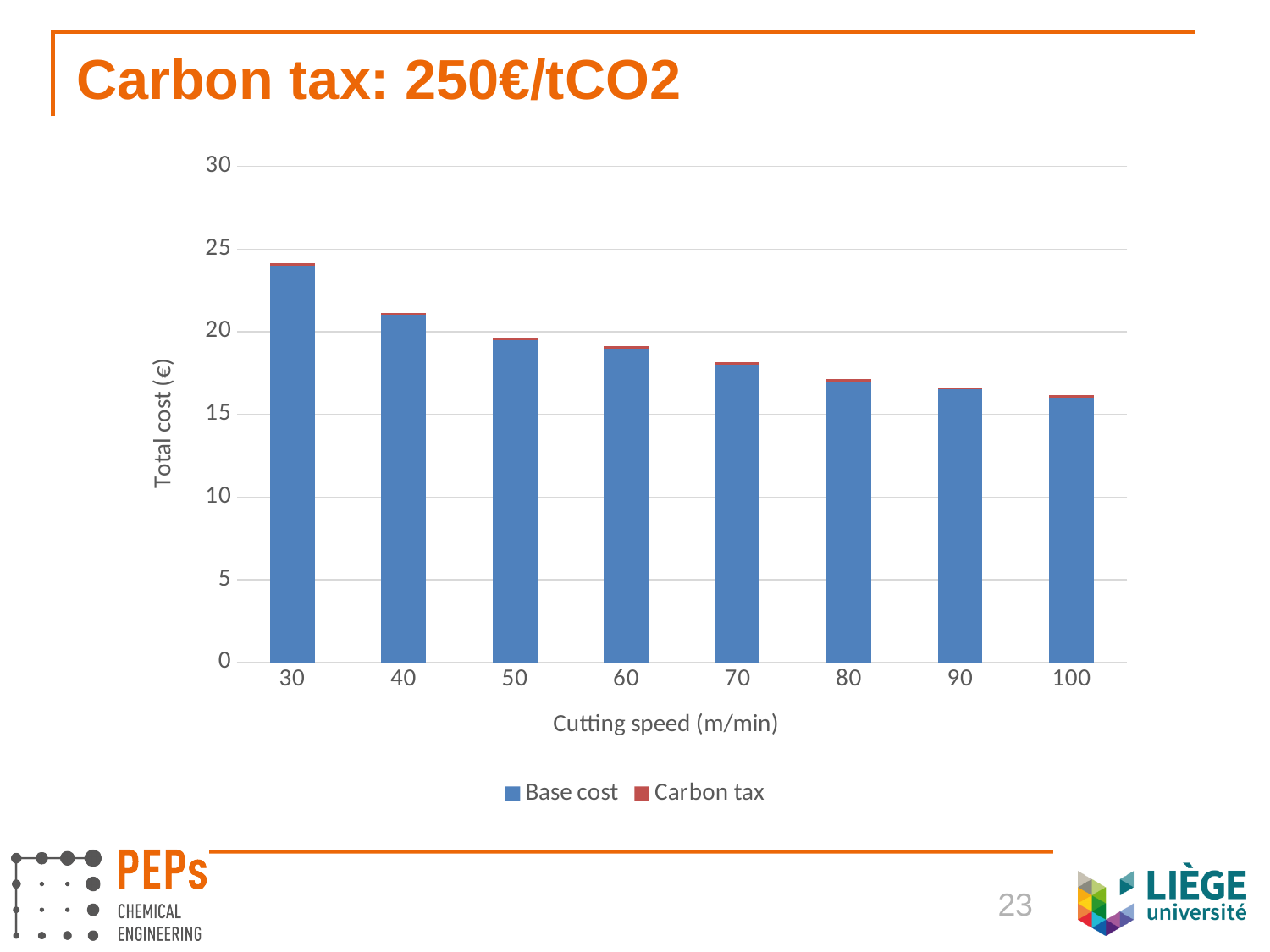
Does the total cost rise or fall as cutting speed increases along the x axis? fall Is the total cost at a cutting speed of 70 m/min greater or less than 20? less Is the total cost at a cutting speed of 30 m/min greater or less than 20? greater Which cutting speed has the highest total cost? 30 How many series does the legend list? 2 Is the total cost at a cutting speed of 100 m/min greater or less than 20? less How many cutting speed categories are shown on the x axis? 8 Which has a larger total cost: a cutting speed of 40 m/min or 90 m/min? 40 What kind of chart is shown on the slide? bar chart What is the label of the y axis? Total cost (€) Which cutting speed has the lowest total cost? 100